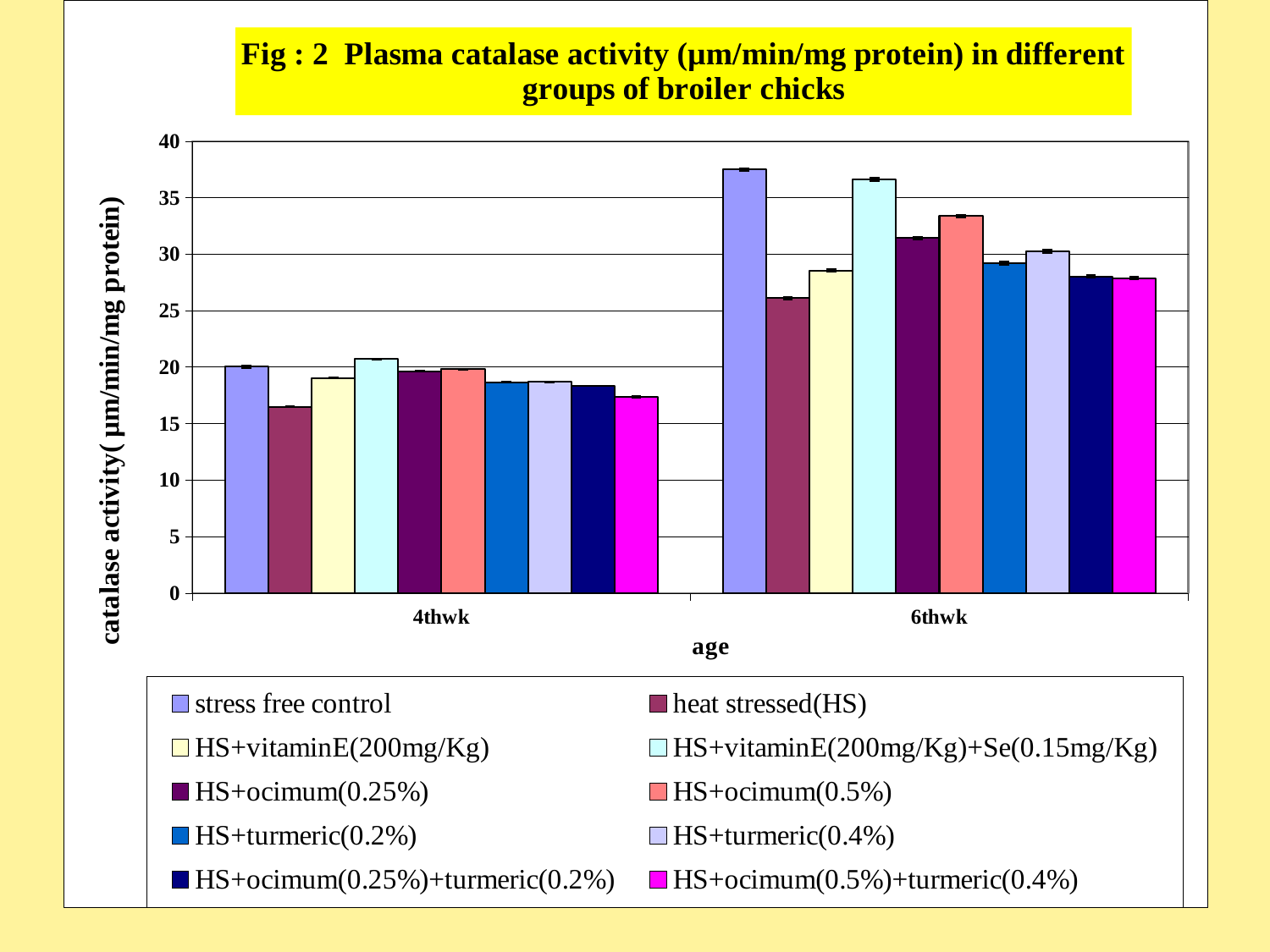
Which group has the highest catalase activity at 6thwk? stress free control What kind of chart is shown on the slide? bar chart Which group has the lowest catalase activity at 4thwk? heat stressed(HS) How many age categories are shown on the x axis? 2 Is the value for heat stressed(HS) at 4thwk greater or less than 20? less Is the value for stress free control at 6thwk greater or less than 35? greater Does the catalase activity for stress free control rise or fall from 4thwk to 6thwk? rise What is the title of the x axis? age Is the value for HS+ocimum(0.5%) at 6thwk greater or less than 30? greater How many series does the legend list? 10 At 6thwk, which is larger: HS+ocimum(0.5%) or HS+ocimum(0.25%)? HS+ocimum(0.5%) Which group has the lowest catalase activity at 6thwk? heat stressed(HS)